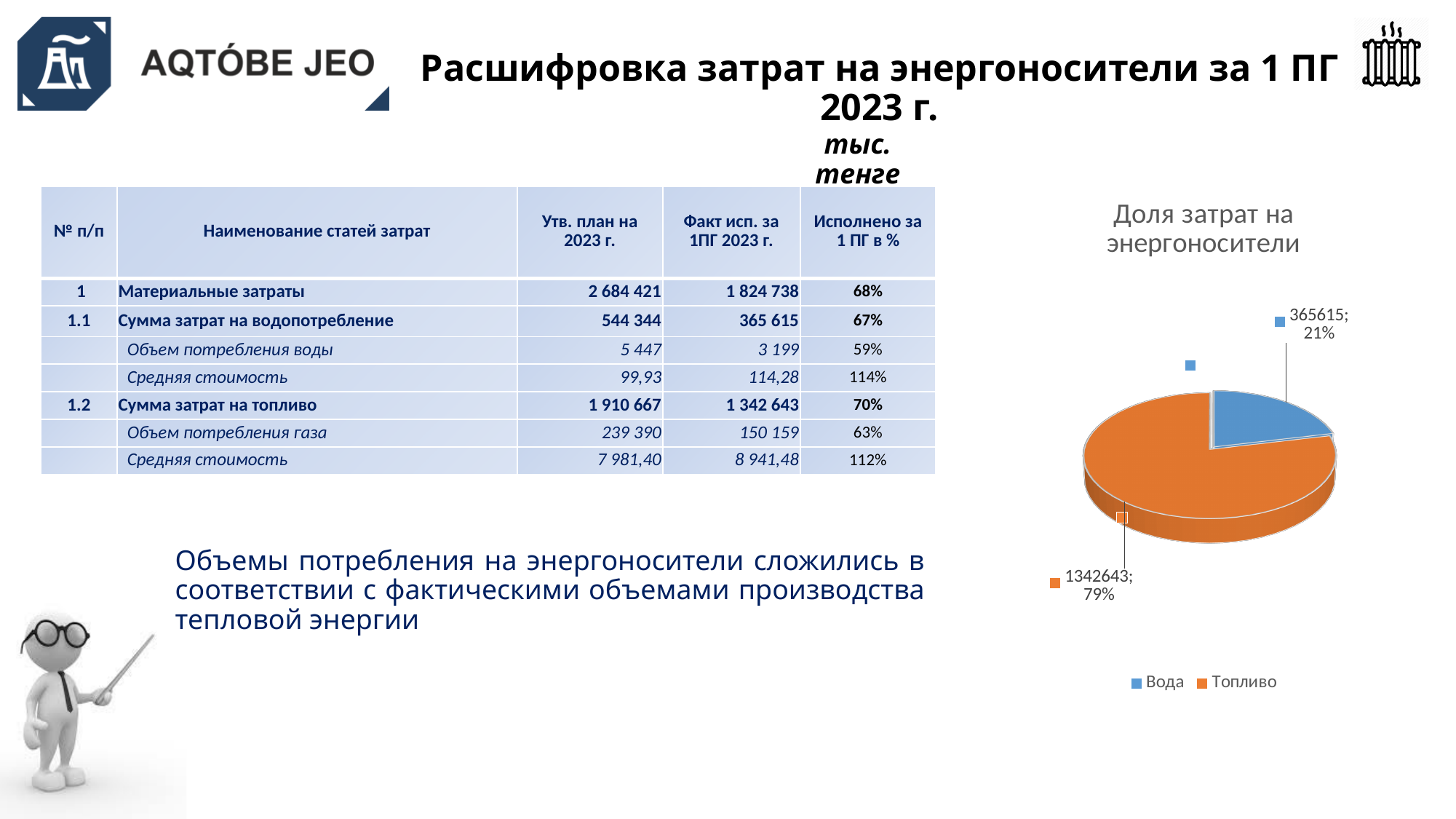
What is the difference between the Топливо and Вода values in the pie chart? 977028 What value is shown for Топливо in the pie chart? 1342643 What is the title of the pie chart? Доля затрат на энергоносители How many entries does the legend of the pie chart list? 2 What value is shown for Вода in the pie chart? 365615 Which slice of the pie chart is the largest? Топливо Which is larger in the pie chart, Вода or Топливо? Топливо What share of the pie does Топливо represent? 79% How many slices does the pie chart have? 2 What share of the pie does Вода represent? 21% What kind of chart is shown on the slide? pie chart Which slice of the pie chart is the smallest? Вода